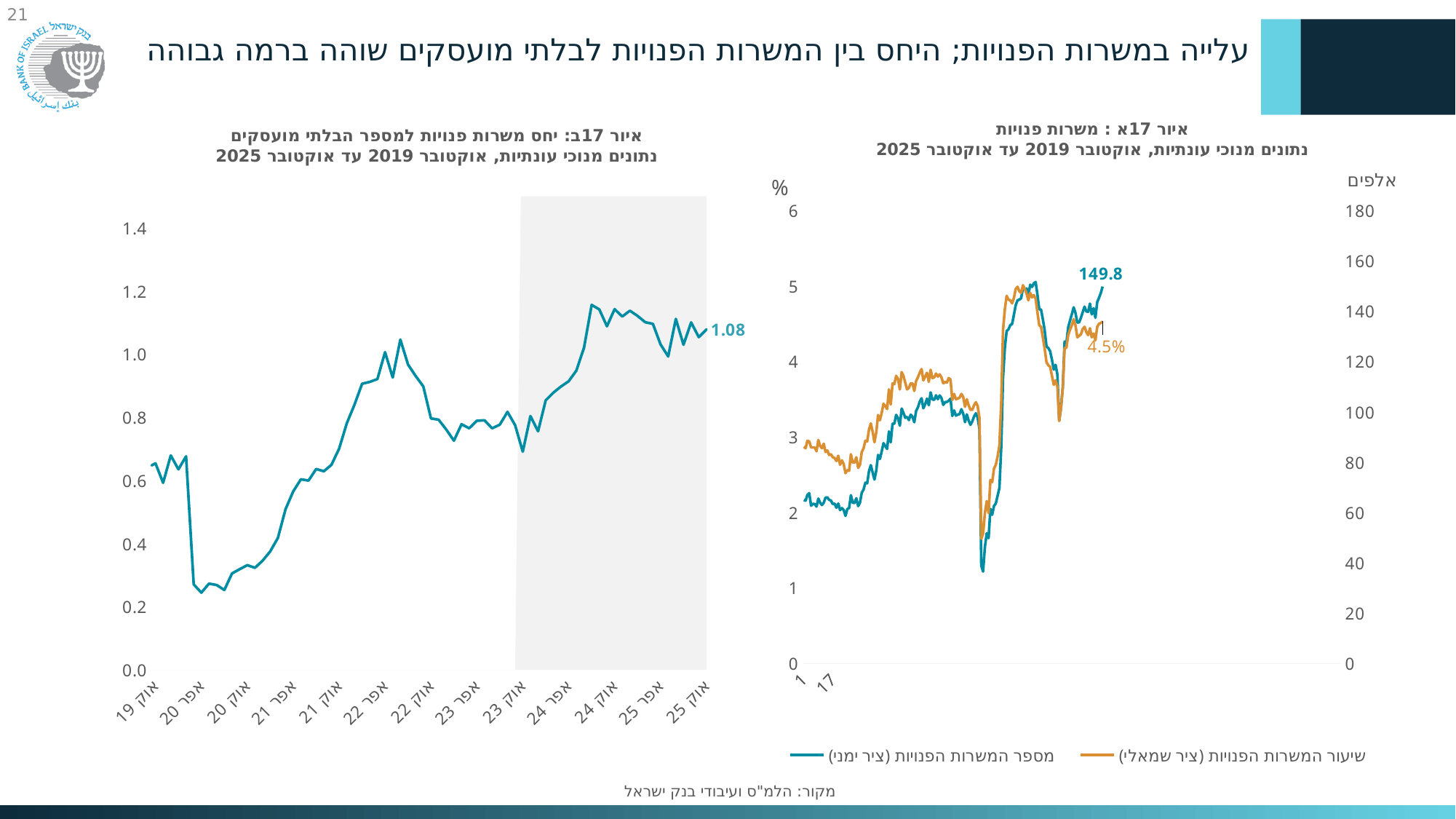
In the left chart ('איור 17ב'), is the value at אוק 23 greater or less than 0.8? less How many x-axis tick labels are shown on the left chart ('איור 17ב')? 13 How many series does the legend of the right chart ('איור 17א: משרות פנויות') list? 2 What kind of chart is the left chart ('איור 17ב')? line chart In the left chart ('איור 17ב'), is the value at אפר 22 greater or less than 0.8? greater In the right chart ('איור 17א'), what unit label appears above the right-hand axis? אלפים In the left chart ('איור 17ב'), is the value at אפר 20 greater or less than 0.4? less In the right chart ('איור 17א'), which series is drawn in orange? שיעור המשרות הפנויות (ציר שמאלי) In the left chart ('איור 17ב'), does the line rise or fall between אפר 20 and אפר 22? rise In the chart titled 'איור 17א: משרות פנויות' (right chart), what is the labelled final value of the number of vacant jobs series (מספר המשרות הפנויות)? 149.8 In the chart titled 'איור 17א: משרות פנויות' (right chart), what is the labelled final value of the vacancy rate series (שיעור המשרות הפנויות)? 4.5% In the chart titled 'איור 17ב: יחס משרות פנויות למספר הבלתי מועסקים' (left chart), what is the value shown by the data label at the end of the line? 1.08